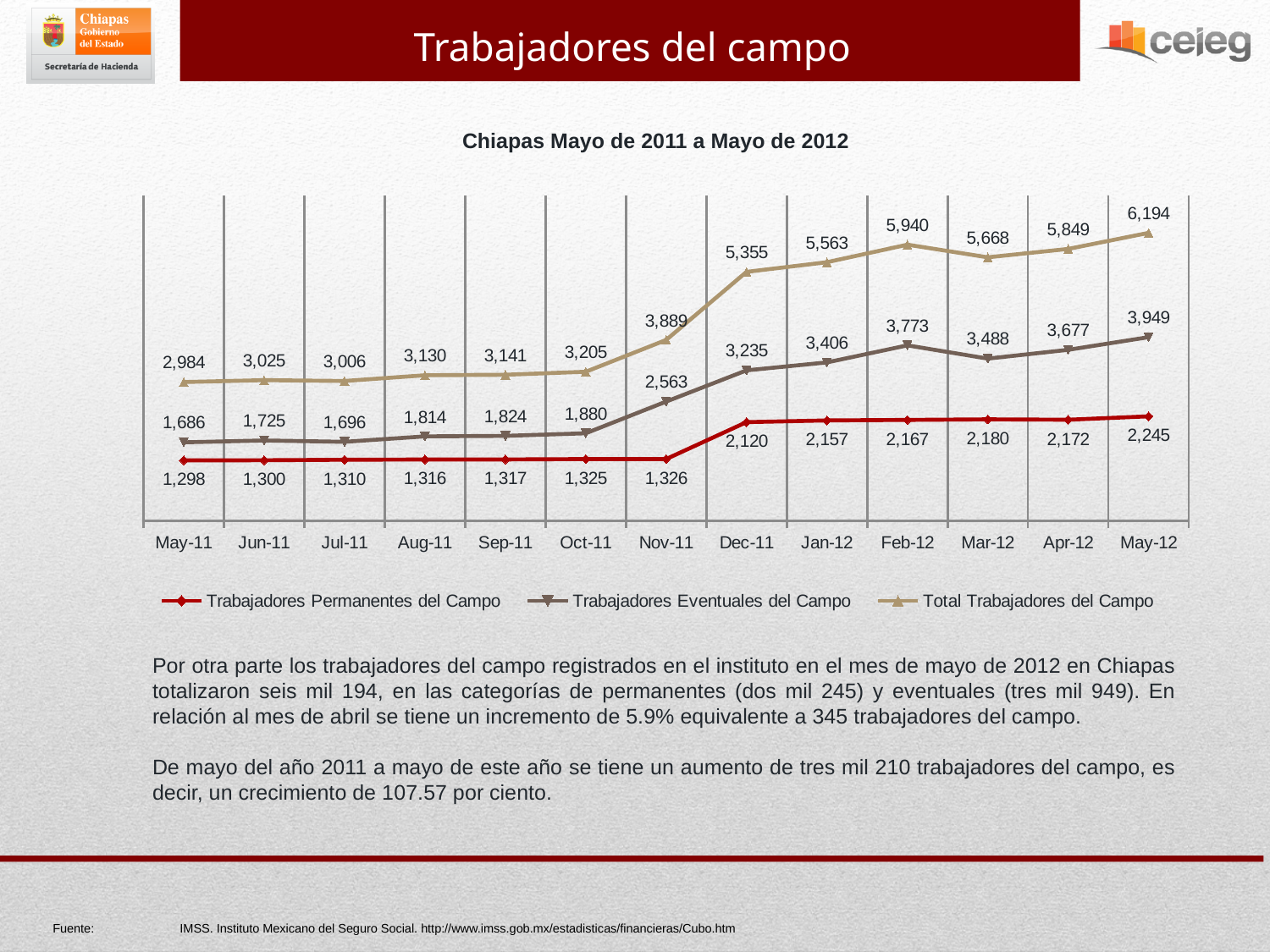
In which month is Total Trabajadores del Campo lowest? May-11 What is the subtitle shown above the chart? Chiapas Mayo de 2011 a Mayo de 2012 Does Trabajadores Permanentes del Campo generally rise or fall from May-11 to May-12? Rise Which is larger: Trabajadores Eventuales del Campo in Feb-12 or in Mar-12? Feb-12 What is the value of Total Trabajadores del Campo in May-12? 6,194 In which month is Trabajadores Eventuales del Campo highest? May-12 What is the difference between Total Trabajadores del Campo in May-12 and in Apr-12? 345 What is the value of Trabajadores Permanentes del Campo in Nov-11? 1,326 What kind of chart is shown on the slide? Line chart What is the value of Trabajadores Eventuales del Campo in Feb-12? 3,773 How many series does the legend list? 3 How many months are shown on the x axis? 13